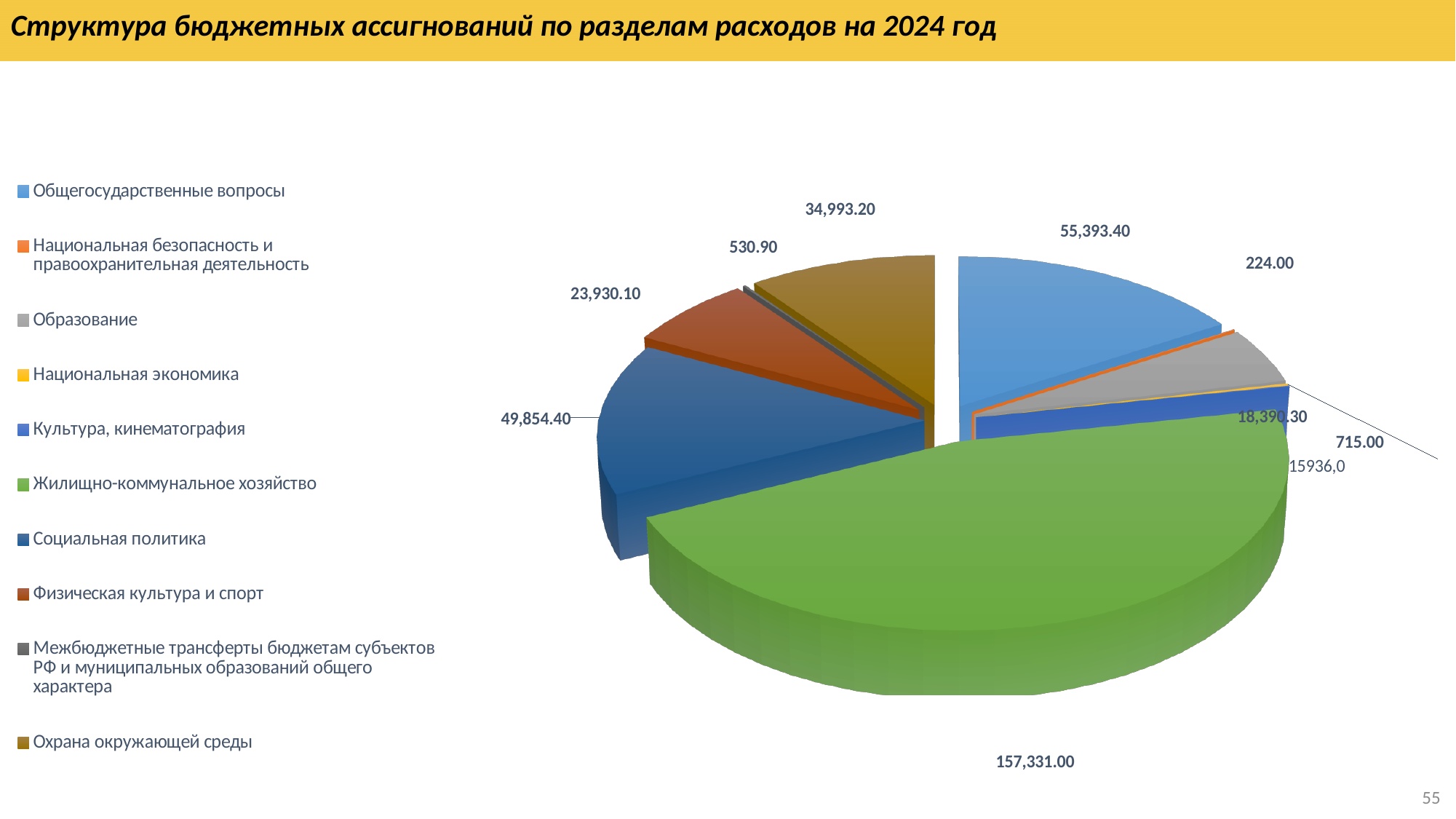
Which is larger: the value for Физическая культура и спорт or the value for Образование? Физическая культура и спорт Which category has the smallest slice of the pie chart? Национальная безопасность и правоохранительная деятельность What is the value shown for Общегосударственные вопросы? 55,393.40 What is the value shown for Социальная политика? 49,854.40 What is the value shown for Охрана окружающей среды? 34,993.20 What is the value shown for Образование? 18,390.30 What is the difference between the values for Общегосударственные вопросы and Охрана окружающей среды? 20,400.20 What is the title of the slide containing the pie chart? Структура бюджетных ассигнований по разделам расходов на 2024 год Which category has the largest slice of the pie chart? Жилищно-коммунальное хозяйство What kind of chart is shown on the slide? pie chart How many categories does the legend of the pie chart list? 10 What is the value shown for Жилищно-коммунальное хозяйство? 157,331.00